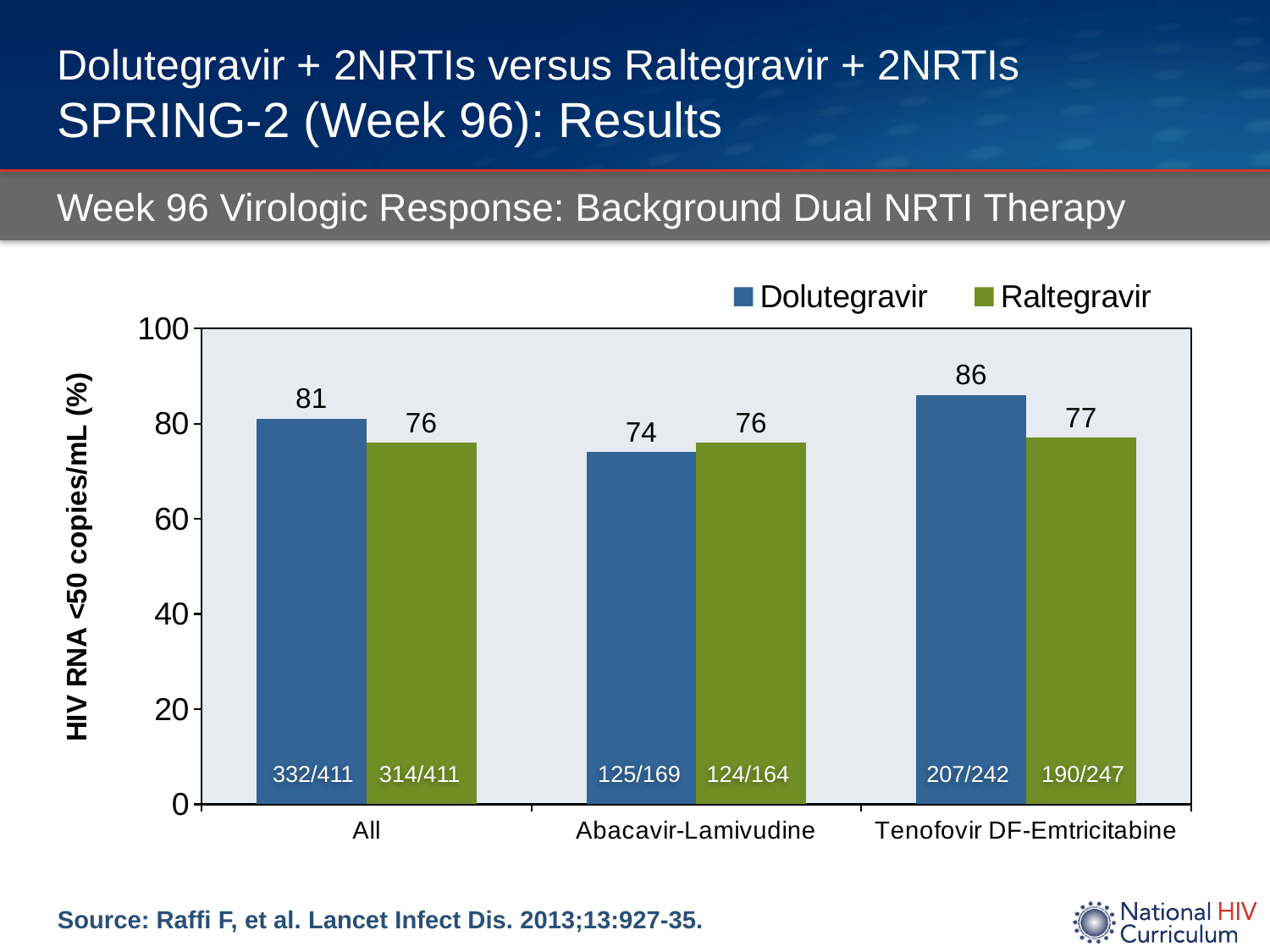
Which group has the lowest Dolutegravir value? Abacavir-Lamivudine What is the value for Dolutegravir in the All group? 81 How many series does the legend list? 2 What is the difference between the Dolutegravir and Raltegravir values in the Tenofovir DF-Emtricitabine group? 9 What is the difference between the Dolutegravir and Raltegravir values in the All group? 5 What is the value for Dolutegravir in the Abacavir-Lamivudine group? 74 Which group has the highest Dolutegravir value? Tenofovir DF-Emtricitabine How many groups are shown on the x axis? 3 In the Abacavir-Lamivudine group, which is larger, the Dolutegravir value or the Raltegravir value? Raltegravir What kind of chart is shown on the slide? Bar chart What fraction is printed on the Dolutegravir bar in the All group? 332/411 What is the value for Raltegravir in the Tenofovir DF-Emtricitabine group? 77